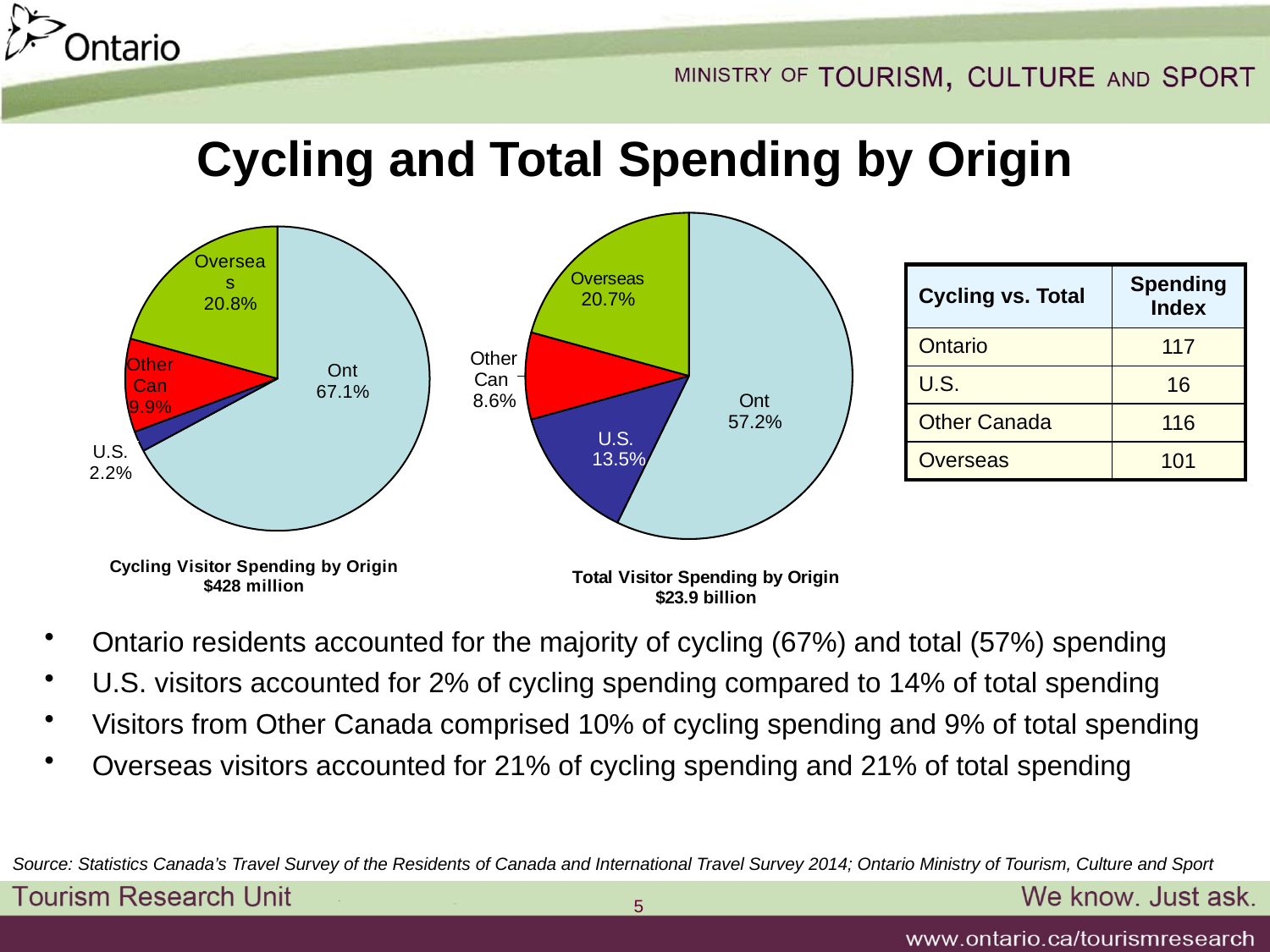
In the Total Visitor Spending by Origin pie chart, what share does U.S. have? 13.5% What total amount is shown under the Cycling Visitor Spending by Origin pie chart? $428 million In the Cycling Visitor Spending by Origin pie chart, what is the difference between the Overseas share and the Other Can share? 10.9% How many slices does the Cycling Visitor Spending by Origin pie chart have? 4 In the Cycling Visitor Spending by Origin pie chart, what share does Ont have? 67.1% In the Cycling Visitor Spending by Origin pie chart, which origin has the smallest share? U.S. In the Total Visitor Spending by Origin pie chart, which origin has the largest share? Ont In the Total Visitor Spending by Origin pie chart, which is larger, the U.S. share or the Other Can share? U.S. What total amount is shown under the Total Visitor Spending by Origin pie chart? $23.9 billion What type of chart is the Total Visitor Spending by Origin chart? Pie chart In the Cycling Visitor Spending by Origin pie chart, what share does Overseas have? 20.8% In the Total Visitor Spending by Origin pie chart, what share does Other Can have? 8.6%